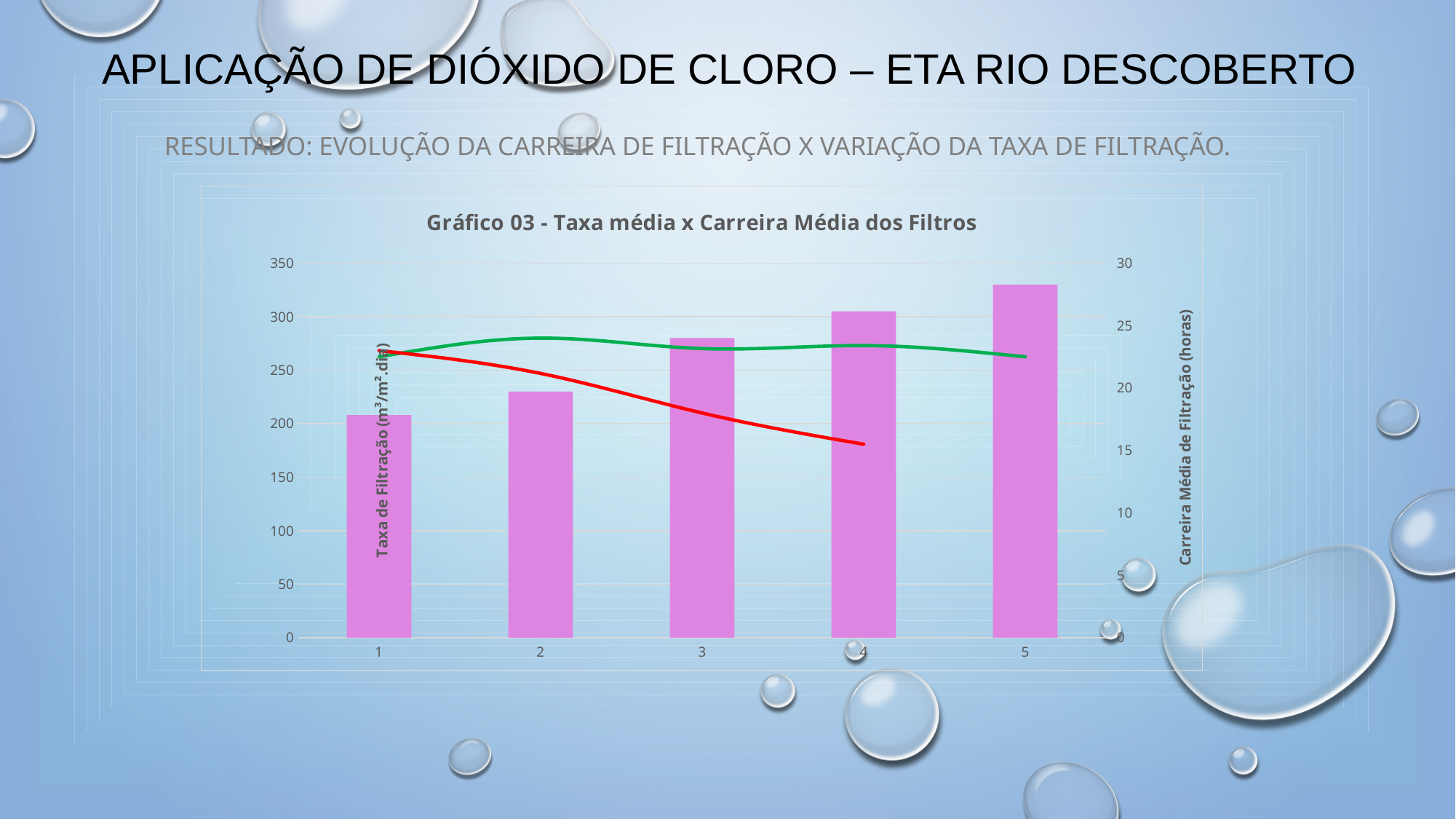
Is the bar value for category 1 greater or less than 250? less What kind of chart is shown on the slide? bar chart with line series Which category has the shortest bar? 1 Which bar is taller, category 3 or category 2? 3 Is the bar value for category 2 greater or less than 250? less Is the bar value for category 5 greater or less than 300? greater What is the title of the chart? Gráfico 03 - Taxa média x Carreira Média dos Filtros Do the bar values rise or fall from category 1 to category 5? rise What is the label of the right-hand vertical axis? Carreira Média de Filtração (horas) How many categories are shown on the x axis of the chart? 5 Which category has the tallest bar? 5